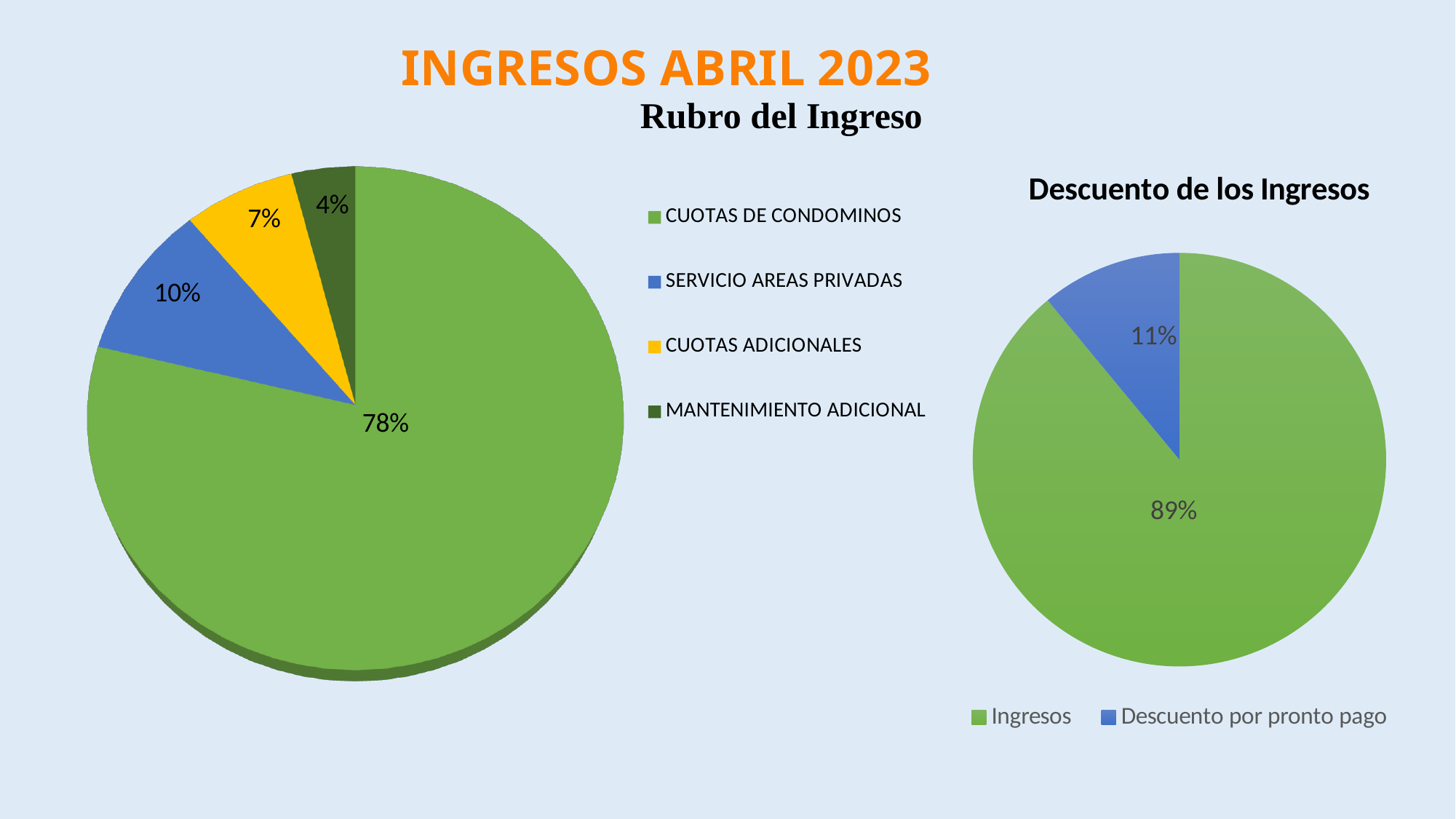
In the 'Rubro del Ingreso' chart, what is the difference between the shares of SERVICIO AREAS PRIVADAS and CUOTAS ADICIONALES? 3% In the 'Rubro del Ingreso' chart, what share does CUOTAS DE CONDOMINOS have? 78% In the 'Descuento de los Ingresos' chart, what share does Descuento por pronto pago have? 11% In the 'Rubro del Ingreso' chart, how many categories are shown? 4 In the 'Rubro del Ingreso' chart, which category has the smallest slice? MANTENIMIENTO ADICIONAL In the 'Rubro del Ingreso' chart, what share does CUOTAS ADICIONALES have? 7% What kind of chart is the 'Descuento de los Ingresos' chart? Pie chart In the 'Descuento de los Ingresos' chart, which is larger, Ingresos or Descuento por pronto pago? Ingresos In the 'Rubro del Ingreso' chart, which category has the largest slice? CUOTAS DE CONDOMINOS